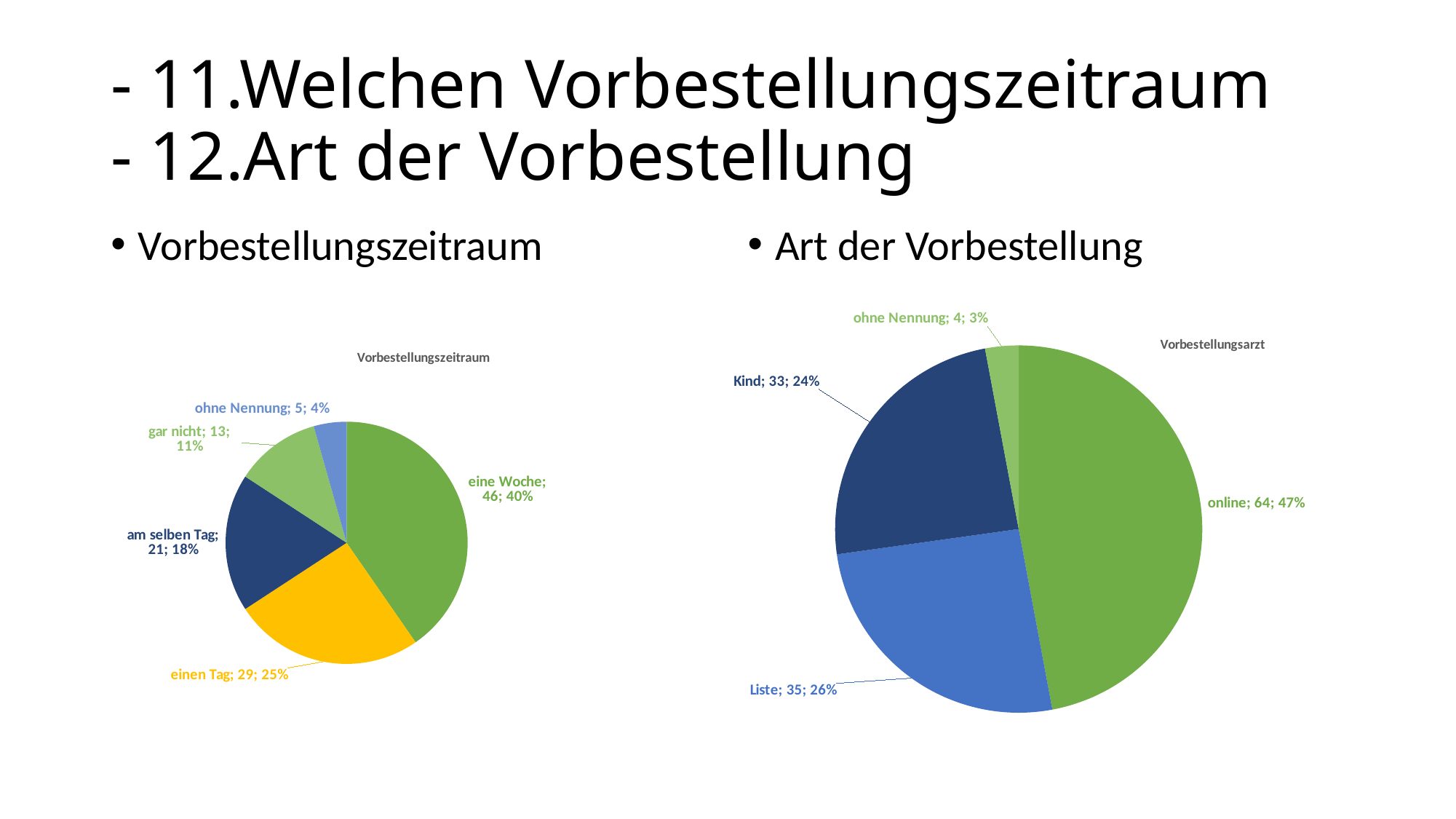
What is the title of the pie chart on the right side of the slide? Vorbestellungsarzt In the 'Vorbestellungszeitraum' pie chart on the left, how many categories are shown? 5 In the 'Vorbestellungsarzt' pie chart on the right, which category has the largest value? online In the 'Vorbestellungszeitraum' pie chart on the left, which category has the smallest value? ohne Nennung In the 'Vorbestellungszeitraum' pie chart on the left, what is the difference between the values for 'eine Woche' and 'am selben Tag'? 25 In the 'Vorbestellungszeitraum' pie chart on the left, which is larger: 'gar nicht' or 'am selben Tag'? am selben Tag In the 'Vorbestellungsarzt' pie chart on the right, what is the difference between the values for 'online' and 'Kind'? 31 What type of chart is the 'Vorbestellungsarzt' chart on the right? pie chart In the 'Vorbestellungsarzt' pie chart on the right, what share of the pie does 'Kind' have? 24% In the 'Vorbestellungsarzt' pie chart on the right, what is the value for 'Liste'? 35 In the 'Vorbestellungszeitraum' pie chart on the left, what share of the pie does 'einen Tag' have? 25% In the 'Vorbestellungszeitraum' pie chart on the left, what is the value for 'eine Woche'? 46